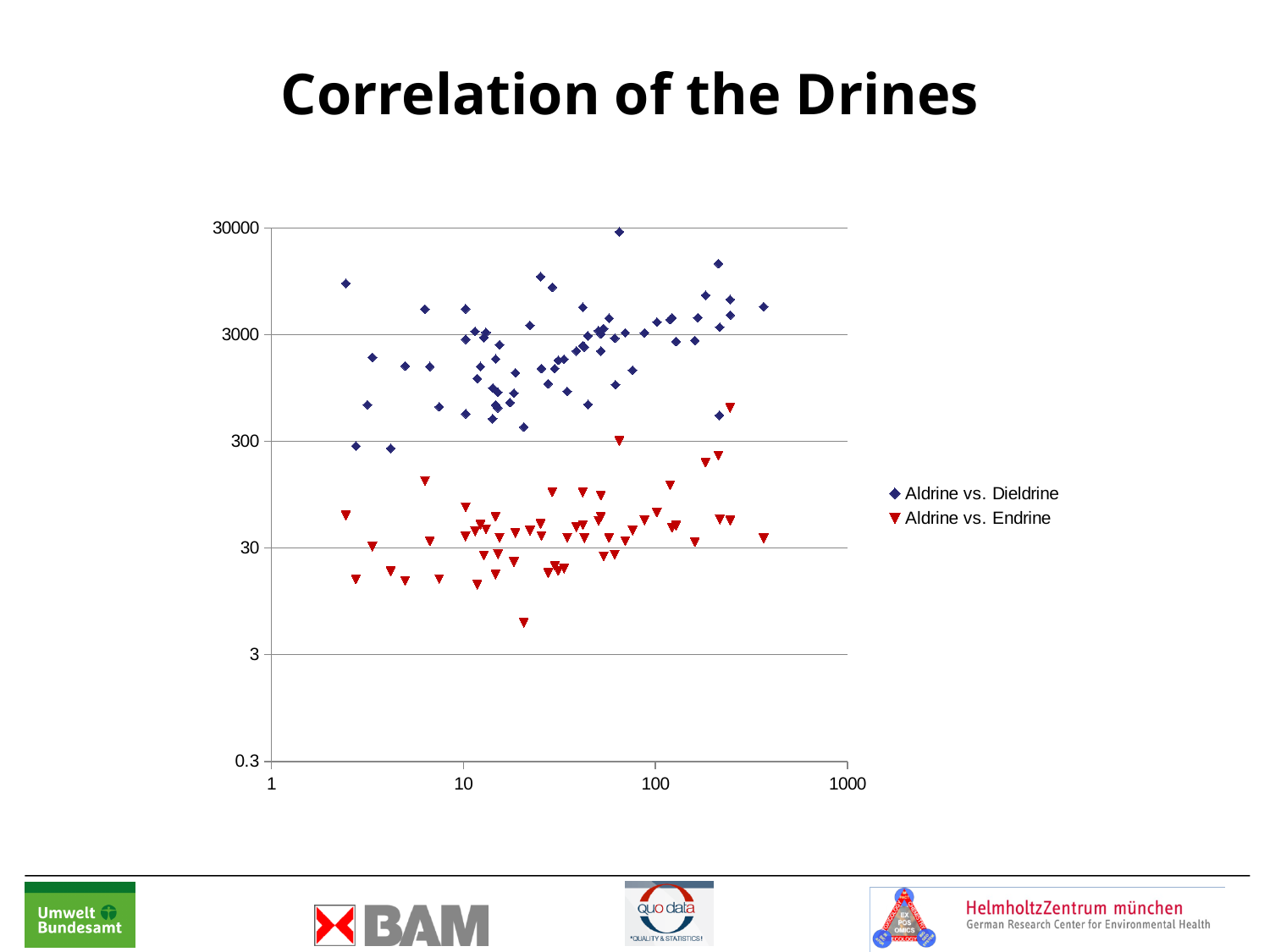
What are the two series named in the legend? Aldrine vs. Dieldrine and Aldrine vs. Endrine What kind of chart is shown on the slide? scatter chart Is the lowest point of the Aldrine vs. Dieldrine series greater or less than 30? greater Is the highest point of the Aldrine vs. Endrine series greater or less than 3000? less Are all points of the Aldrine vs. Endrine series greater or less than 3 on the y axis? greater Which series generally has the higher y-axis values, Aldrine vs. Dieldrine or Aldrine vs. Endrine? Aldrine vs. Dieldrine What is the title of the chart? Correlation of the Drines How many series does the legend list? 2